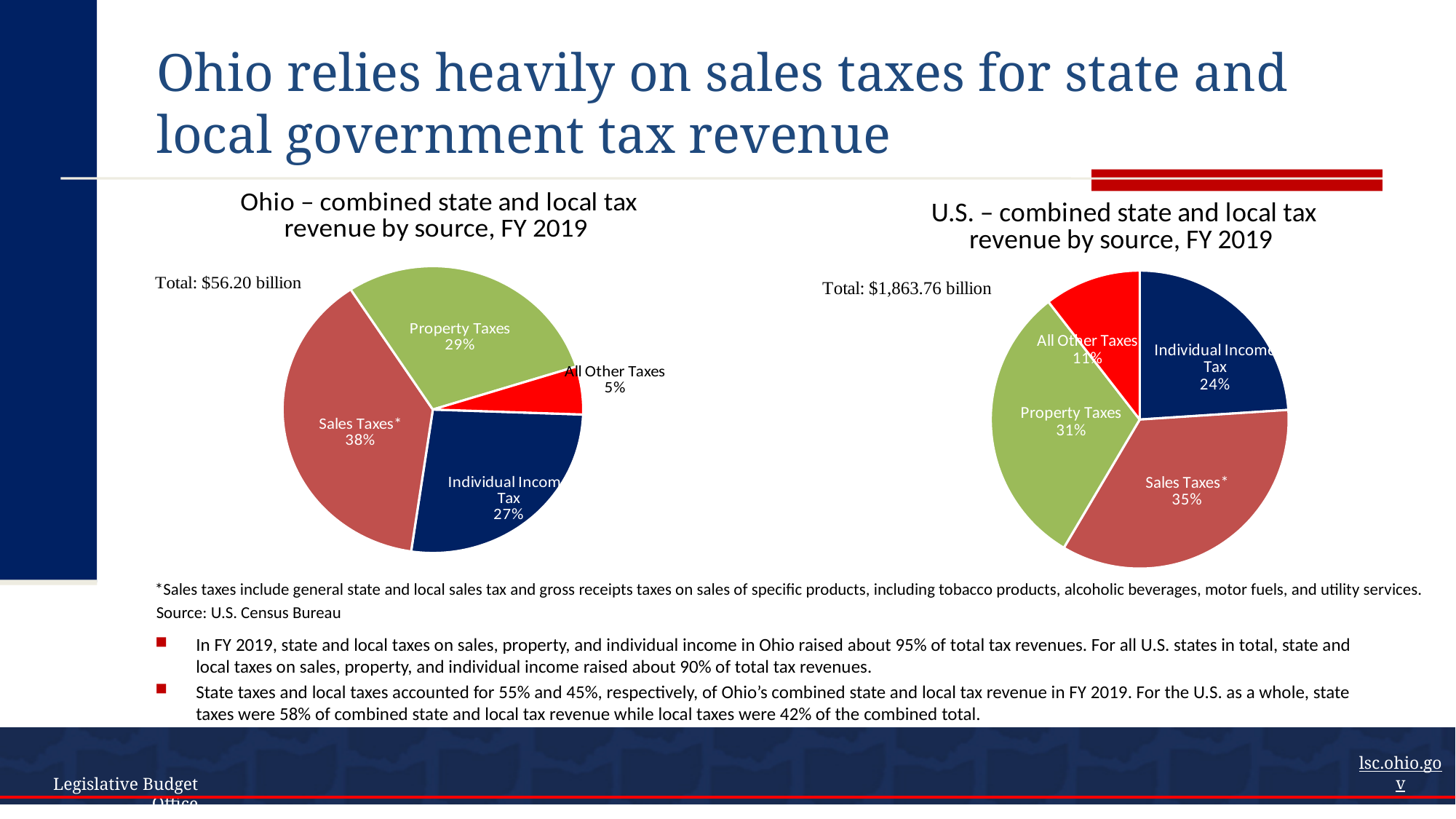
How many slices does the Ohio pie chart have? 4 What type of chart is used for the U.S. combined state and local tax revenue by source? Pie chart Which is larger: the Property Taxes share in the Ohio chart or the Property Taxes share in the U.S. chart? U.S. chart In the Ohio pie chart, what share is Individual Income Tax? 27% In the Ohio pie chart, what share of combined state and local tax revenue comes from Sales Taxes? 38% In the Ohio pie chart, which source has the largest share? Sales Taxes In the U.S. pie chart, what share of combined state and local tax revenue comes from Property Taxes? 31% In the U.S. pie chart, which source has the smallest share? All Other Taxes What total is shown next to the U.S. pie chart? $1,863.76 billion What is the difference in percentage points between the Sales Taxes share in the Ohio chart and the Sales Taxes share in the U.S. chart? 3 percentage points In the U.S. pie chart, what share is All Other Taxes? 11% What total is shown next to the Ohio pie chart? $56.20 billion